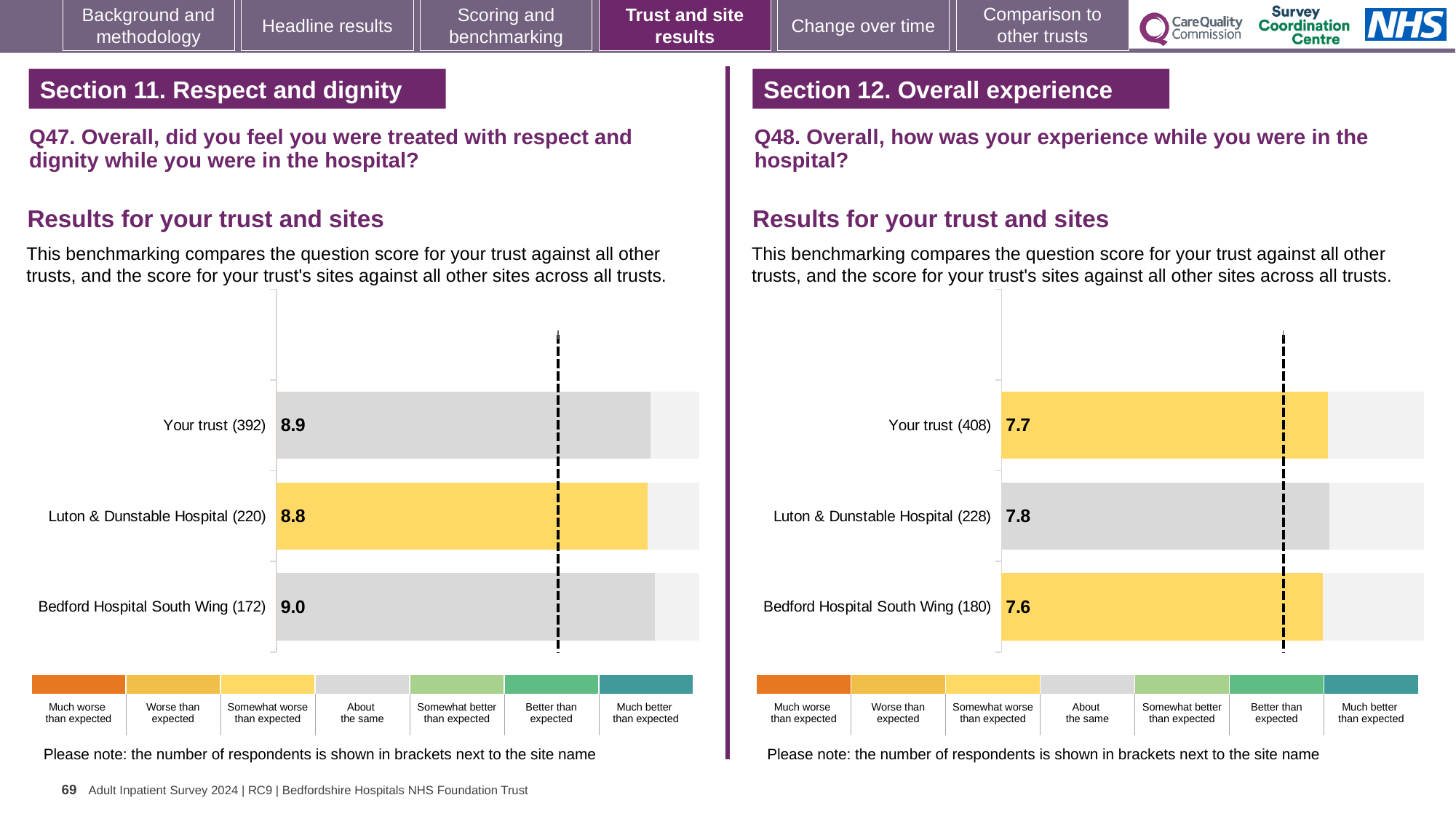
In the Q48 chart on the right, how many respondents are shown in brackets for Your trust? 408 How many bars are shown in the Q47 chart on the left? 3 In the Q48 chart on the right, which site or trust has the lowest score? Bedford Hospital South Wing What kind of chart is used in the Q48 chart on the right? Bar chart In the Q47 chart on the left, which site or trust has the highest score? Bedford Hospital South Wing In the Q48 chart on the right, what is the score for Bedford Hospital South Wing? 7.6 In the Q47 chart on the left, what is the score for Your trust? 8.9 In the Q48 chart on the right, what is the score for Luton & Dunstable Hospital? 7.8 In the Q48 chart on the right, which has the larger score, Your trust or Luton & Dunstable Hospital? Luton & Dunstable Hospital In the Q47 chart on the left, what is the difference between the scores for Bedford Hospital South Wing and Luton & Dunstable Hospital? 0.2 In the Q48 chart on the right, what is the difference between the scores for Luton & Dunstable Hospital and Your trust? 0.1 In the Q47 chart on the left, what is the score for Bedford Hospital South Wing? 9.0